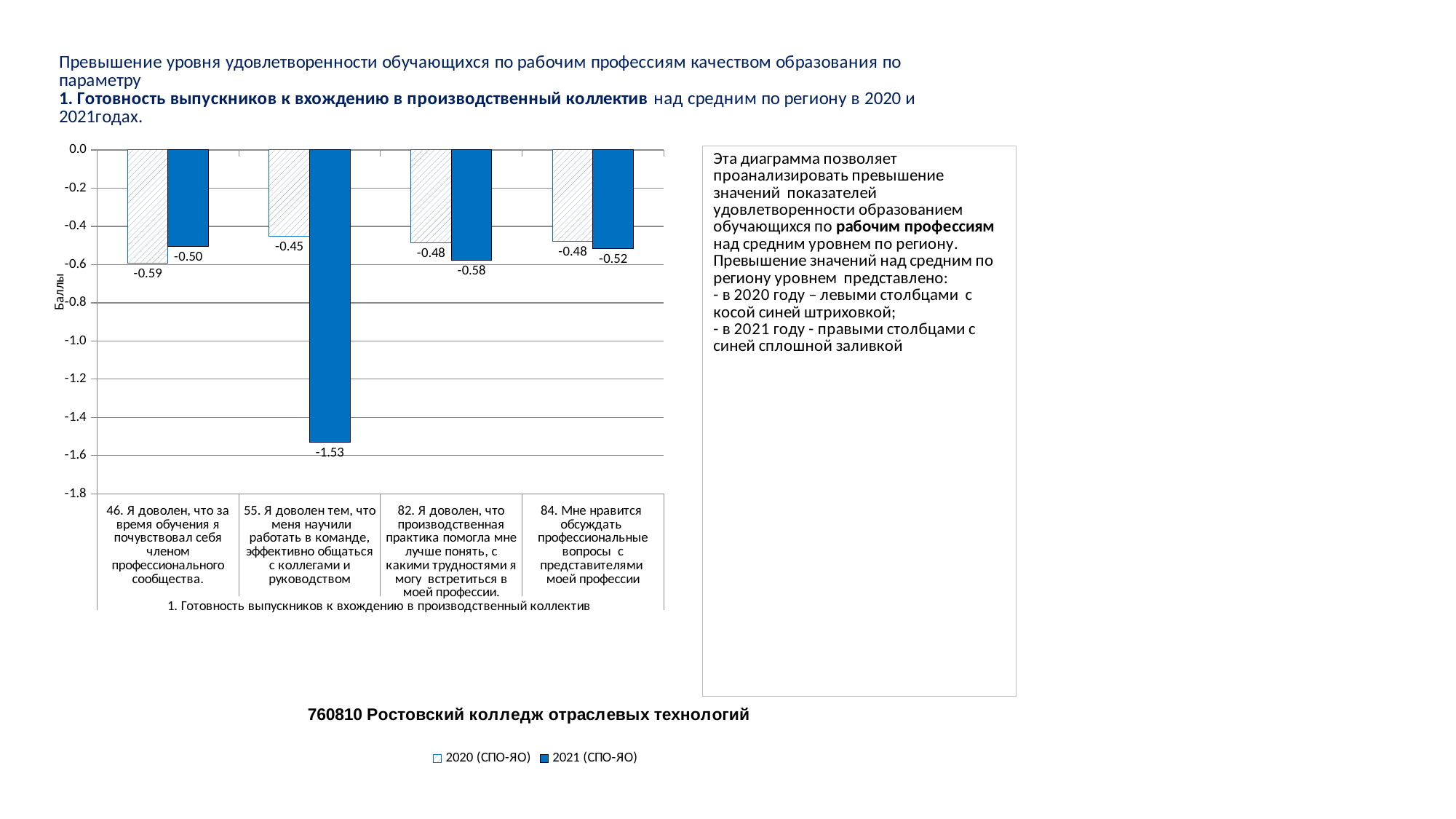
Which category has the highest 2020 (СПО-ЯО) value? 55. Я доволен тем, что меня научили работать в команде, эффективно общаться с коллегами и руководством For category 46, which series has the higher value, 2020 (СПО-ЯО) or 2021 (СПО-ЯО)? 2021 (СПО-ЯО) How many categories are shown on the x axis of the chart? 4 What is the 2020 (СПО-ЯО) value for category 46 ("Я доволен, что за время обучения я почувствовал себя членом профессионального сообщества")? -0.59 What is the 2021 (СПО-ЯО) value for category 82 ("Я доволен, что производственная практика помогла мне лучше понять...")? -0.58 What is the label of the vertical axis of the chart? Баллы What is the difference between the 2020 and 2021 values for category 55? 1.08 Which category has the lowest 2021 (СПО-ЯО) value? 55. Я доволен тем, что меня научили работать в команде, эффективно общаться с коллегами и руководством What type of chart is shown on the slide? Bar chart What is the 2020 (СПО-ЯО) value for category 84 ("Мне нравится обсуждать профессиональные вопросы...")? -0.48 What is the 2021 (СПО-ЯО) value for category 55 ("Я доволен тем, что меня научили работать в команде...")? -1.53 How many series does the chart legend list? 2